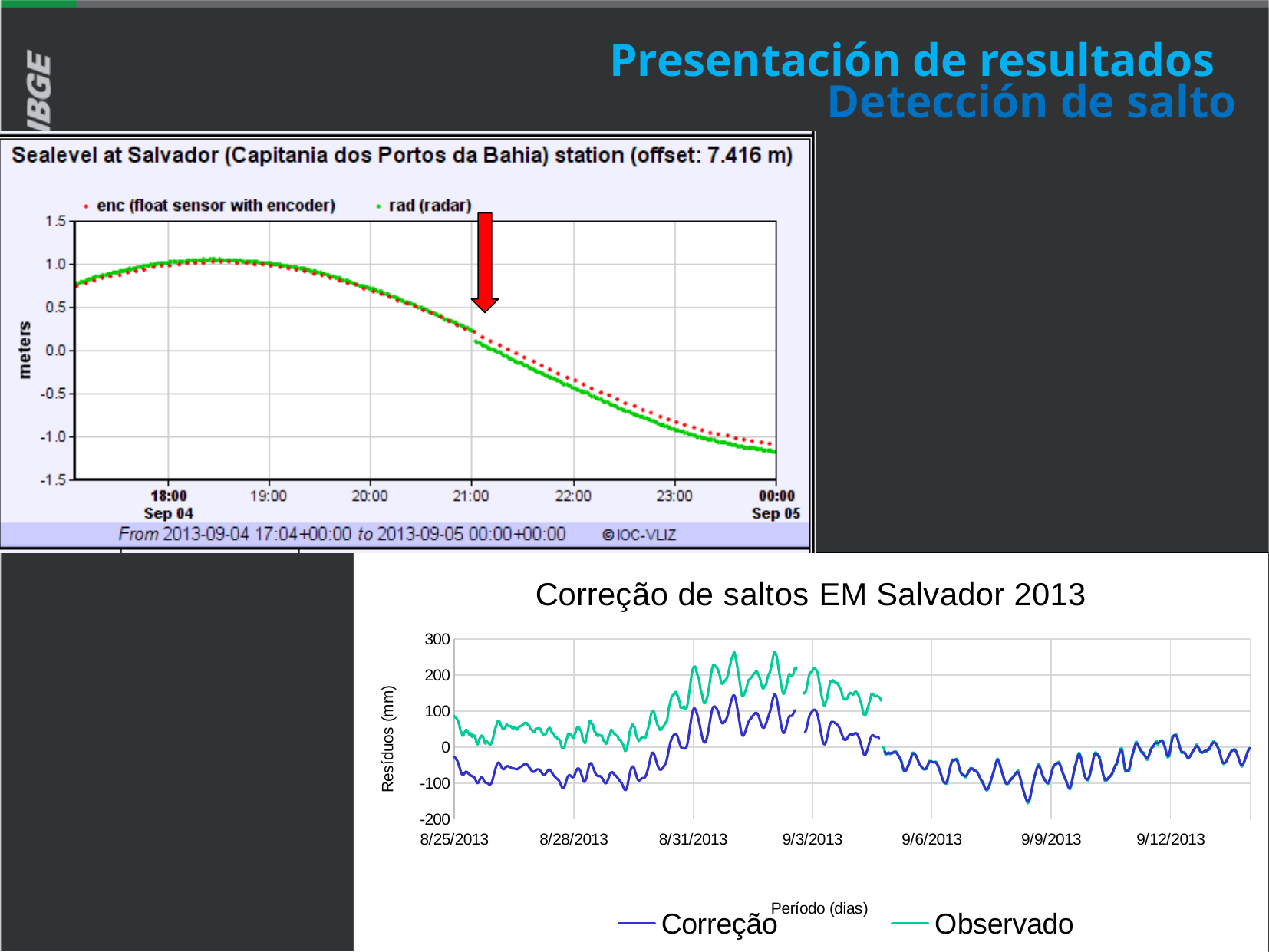
In the bottom chart "Correção de saltos EM Salvador 2013", what is the y-axis label? Resíduos (mm) In the top chart "Sealevel at Salvador (Capitania dos Portos da Bahia) station", do the values rise or fall between 19:00 and 00:00? fall In the bottom chart "Correção de saltos EM Salvador 2013", is the Observado value at 8/25/2013 greater or less than 0? greater How many series does the legend of the bottom chart "Correção de saltos EM Salvador 2013" list? 2 How many series does the legend of the top chart "Sealevel at Salvador (Capitania dos Portos da Bahia) station" list? 2 In the top chart "Sealevel at Salvador (Capitania dos Portos da Bahia) station", is the rad (radar) value at 00:00 Sep 05 greater or less than -1.0 meters? less In the top chart "Sealevel at Salvador (Capitania dos Portos da Bahia) station", at 23:00 which series has the larger value, enc (float sensor with encoder) or rad (radar)? enc (float sensor with encoder) What kind of chart is the bottom chart titled "Correção de saltos EM Salvador 2013"? line chart In the bottom chart "Correção de saltos EM Salvador 2013", what are the two series named in the legend? Correção and Observado In the bottom chart "Correção de saltos EM Salvador 2013", around 9/1/2013, which series has the larger value, Correção or Observado? Observado In the bottom chart "Correção de saltos EM Salvador 2013", is the Correção value at 8/25/2013 greater or less than 0? less